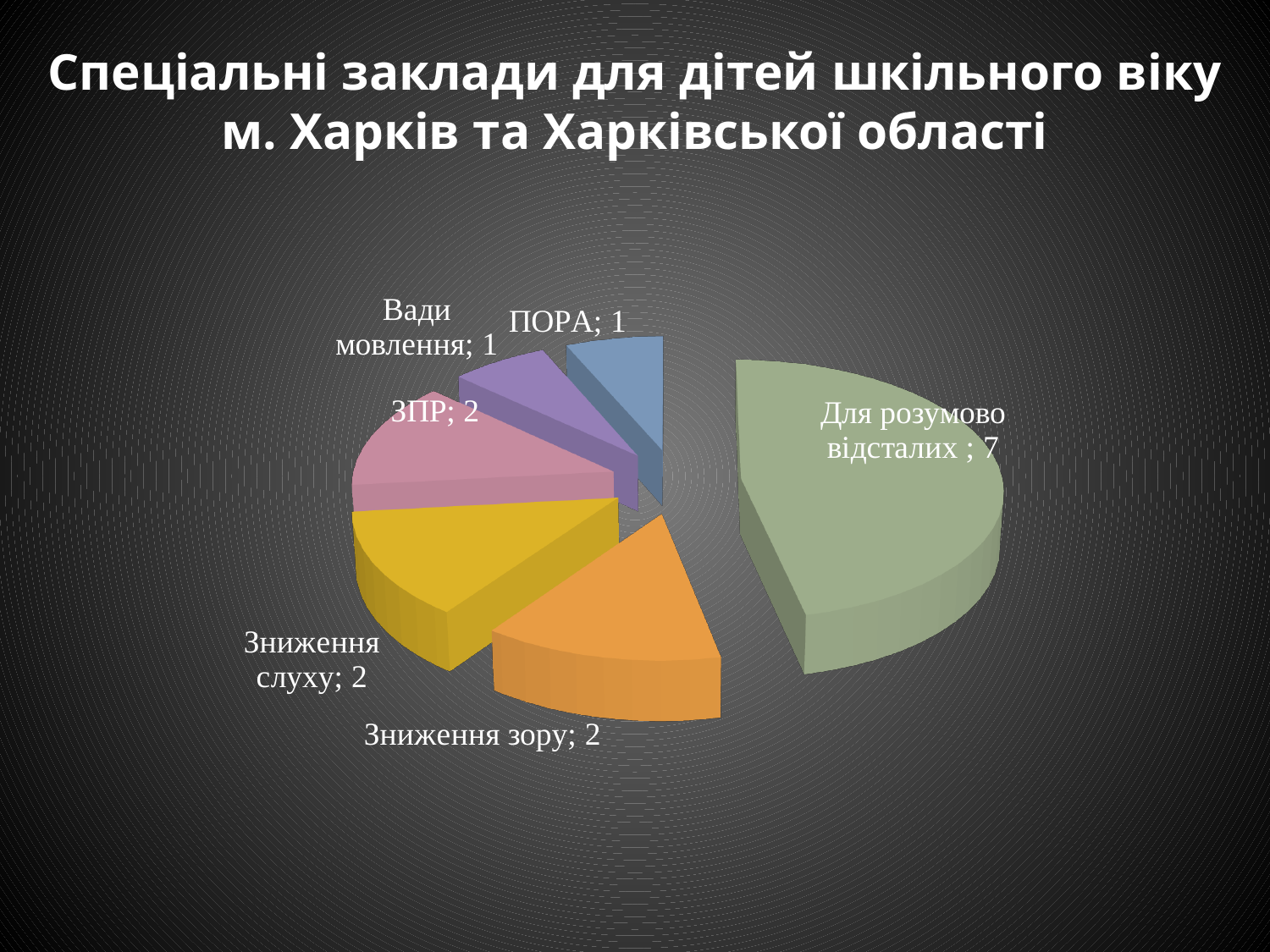
Which two categories have the smallest slices in the pie chart? Вади мовлення and ПОРА What is the total of all the values shown in the pie chart? 15 What is the difference between the value for 'Для розумово відсталих' and the value for 'ЗПР'? 5 How many categories (slices) does the pie chart have? 6 What is the value for the slice 'Зниження зору'? 2 Which category has the largest slice in the pie chart? Для розумово відсталих What is the title of the slide containing the pie chart? Спеціальні заклади для дітей шкільного віку м. Харків та Харківської області Which is larger, the value for 'Зниження слуху' or the value for 'ПОРА'? Зниження слуху What is the value for the slice 'ПОРА'? 1 What is the value for the slice 'Вади мовлення'? 1 What type of chart is shown on the slide? Pie chart What is the value for the slice 'Для розумово відсталих'? 7